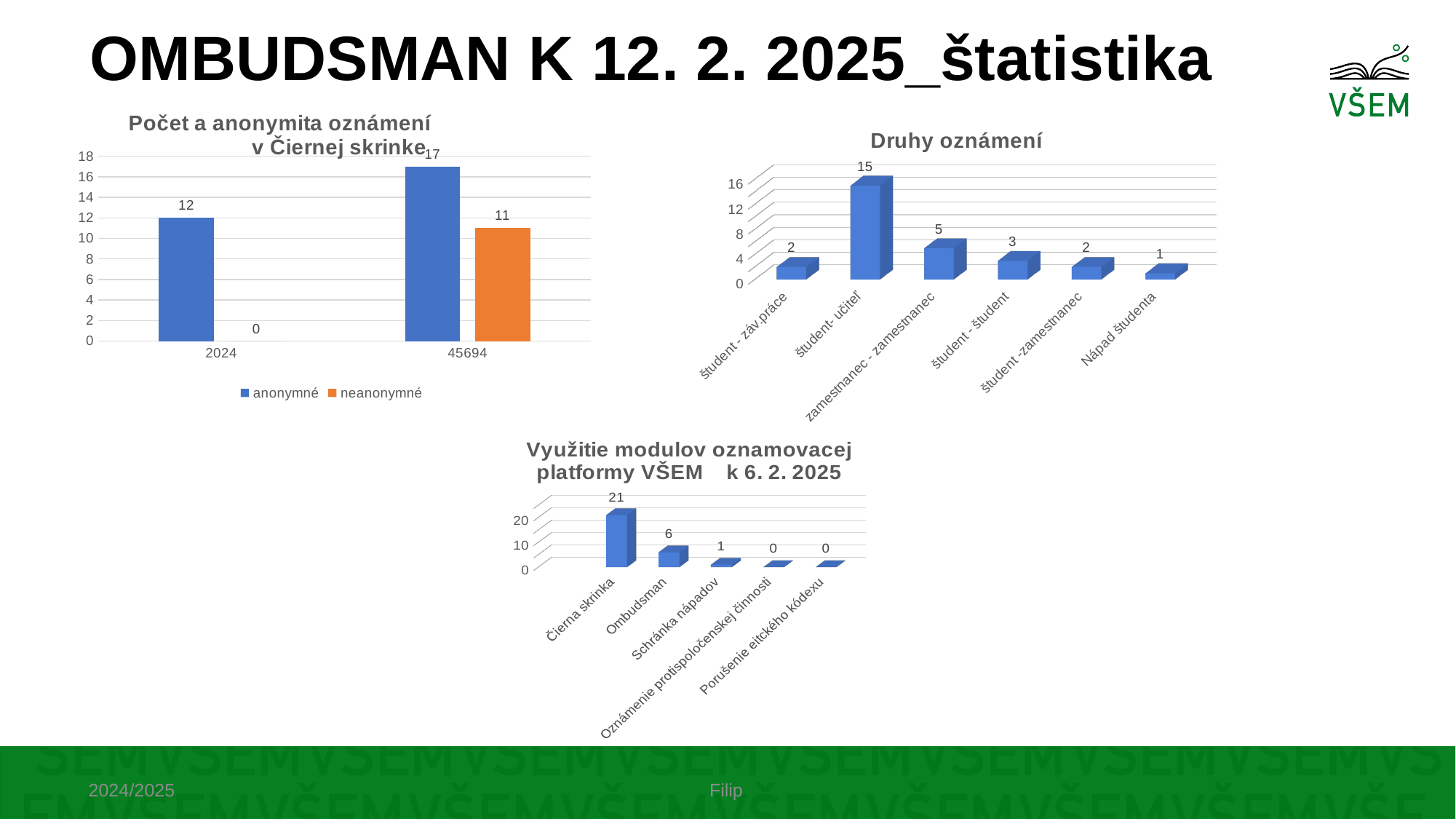
In the chart 'Druhy oznámení', what is the value for zamestnanec - zamestnanec? 5 In the chart 'Využitie modulov oznamovacej platformy VŠEM k 6. 2. 2025', what is the difference between Čierna skrinka and Ombudsman? 15 What kind of chart is 'Využitie modulov oznamovacej platformy VŠEM k 6. 2. 2025'? bar chart In the chart 'Druhy oznámení', how many categories are shown? 6 In the chart 'Druhy oznámení', which category has the highest value? študent- učiteľ In the chart 'Počet a anonymita oznámení v Čiernej skrinke', what is the value for neanonymné in the category 45694? 11 In the chart 'Počet a anonymita oznámení v Čiernej skrinke', what is the difference between anonymné and neanonymné in the category 45694? 6 In the chart 'Počet a anonymita oznámení v Čiernej skrinke', how many series does the legend list? 2 In the chart 'Druhy oznámení', which category has the lowest value? Nápad študenta In the chart 'Počet a anonymita oznámení v Čiernej skrinke', what is the value for anonymné in 2024? 12 In the chart 'Využitie modulov oznamovacej platformy VŠEM k 6. 2. 2025', what is the value for Ombudsman? 6 In the chart 'Počet a anonymita oznámení v Čiernej skrinke', what is the total of anonymné and neanonymné for 2024? 12